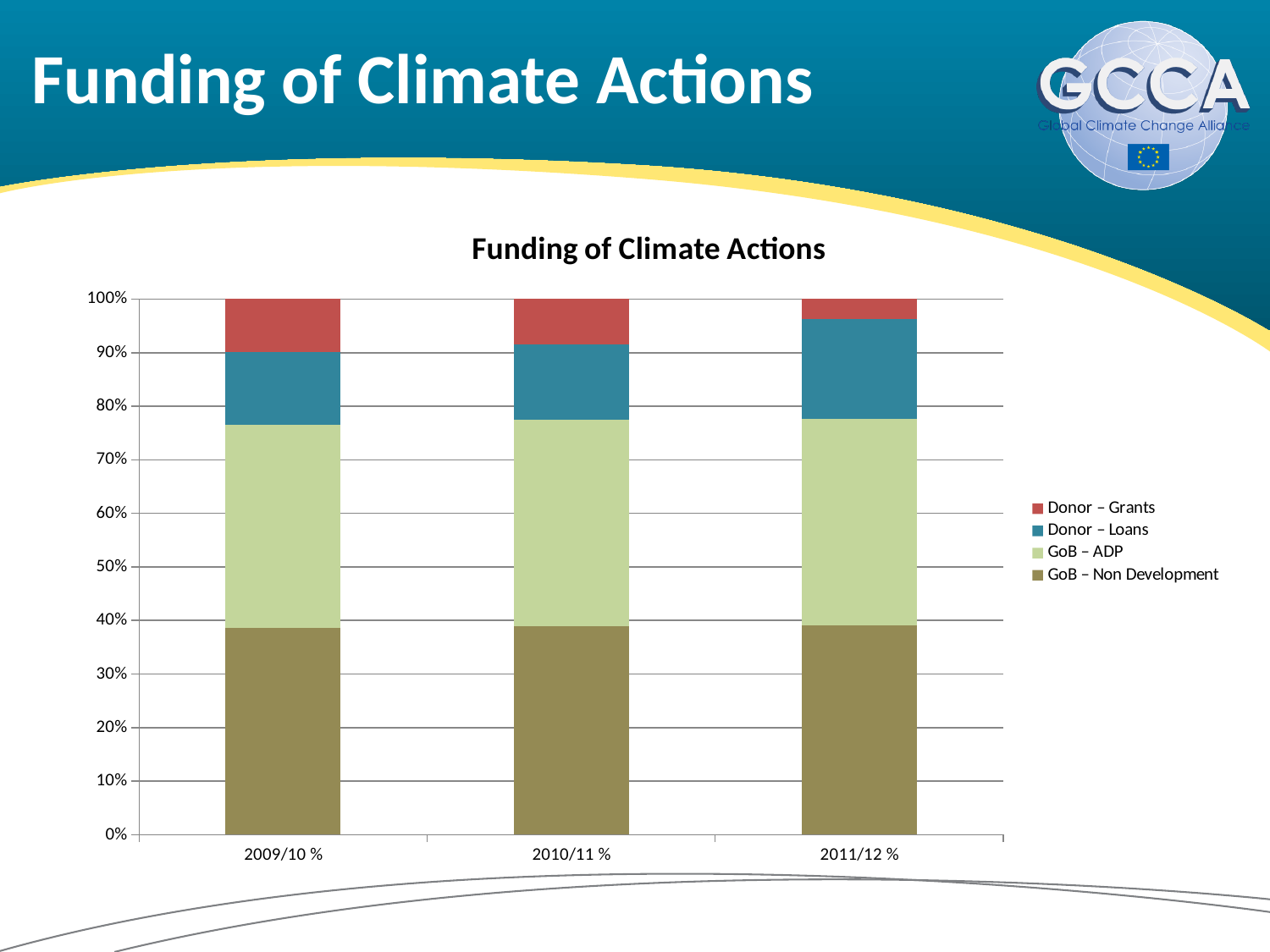
Does the Donor – Grants share rise or fall from 2009/10 % to 2011/12 %? fall Which series is shown in red at the top of each bar? Donor – Grants Is the Donor – Loans share for 2011/12 % greater or less than 10%? greater Is the Donor – Grants share larger in 2009/10 % or in 2011/12 %? 2009/10 % How many series does the legend list? 4 Is the Donor – Grants share for 2011/12 % greater or less than 10%? less Is the GoB – Non Development share for 2009/10 % greater or less than 30%? greater Which year has the largest Donor – Loans share? 2011/12 % Which year has the smallest Donor – Grants share? 2011/12 % What is the title of the chart? Funding of Climate Actions How many fiscal-year categories are shown on the x axis? 3 What kind of chart is shown on the slide? Stacked bar chart